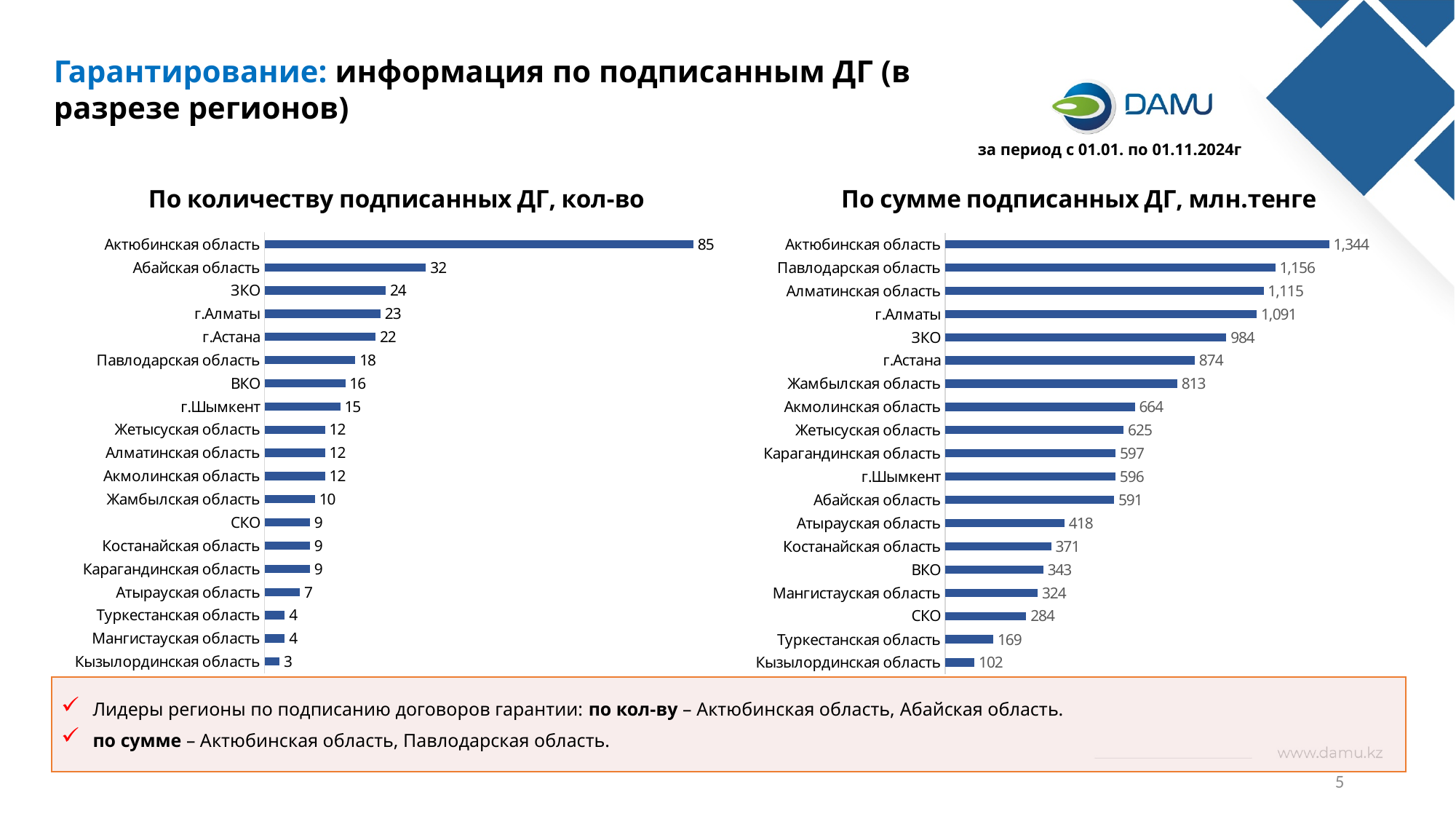
In the chart 'По сумме подписанных ДГ, млн.тенге', which region has the lowest value? Кызылординская область How many regions are shown in the chart 'По сумме подписанных ДГ, млн.тенге'? 19 In the chart 'По количеству подписанных ДГ, кол-во', what is the difference between Актюбинская область and Абайская область? 53 In the chart 'По сумме подписанных ДГ, млн.тенге', what is the value for Павлодарская область? 1,156 What period is stated on the slide for the data? с 01.01. по 01.11.2024г In the chart 'По количеству подписанных ДГ, кол-во', which region has the highest value? Актюбинская область In the chart 'По сумме подписанных ДГ, млн.тенге', what is the difference between Актюбинская область and Павлодарская область? 188 In the chart 'По количеству подписанных ДГ, кол-во', which is larger: г.Алматы or Павлодарская область? г.Алматы What kind of chart is 'По количеству подписанных ДГ, кол-во'? Bar chart In the chart 'По количеству подписанных ДГ, кол-во', what is the value for Кызылординская область? 3 In the chart 'По сумме подписанных ДГ, млн.тенге', which is larger: ЗКО or г.Астана? ЗКО In the chart 'По количеству подписанных ДГ, кол-во', what is the value for Абайская область? 32